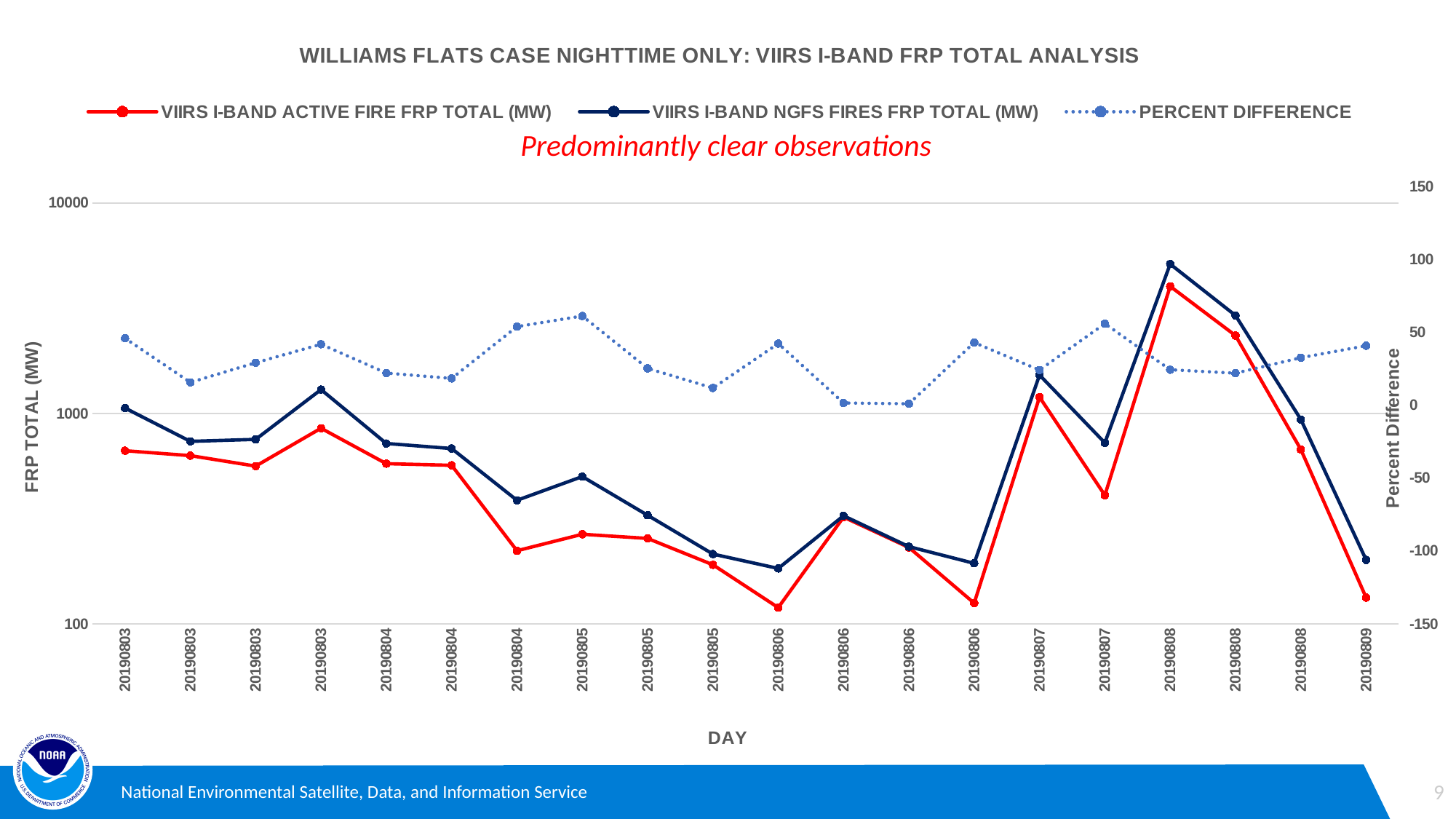
What is the title of the chart? WILLIAMS FLATS CASE NIGHTTIME ONLY: VIIRS I-BAND FRP TOTAL ANALYSIS How many data points are plotted along the x axis for each series? 20 At the first 20190803 point, which series is higher: VIIRS I-BAND ACTIVE FIRE FRP TOTAL (MW) or VIIRS I-BAND NGFS FIRES FRP TOTAL (MW)? VIIRS I-BAND NGFS FIRES FRP TOTAL (MW) On which day does the VIIRS I-BAND ACTIVE FIRE FRP TOTAL (MW) series reach its highest value? 20190808 How many series does the legend list? 3 Which series is drawn with a dotted line? PERCENT DIFFERENCE What kind of chart is shown on the slide? line chart Do the two FRP TOTAL series rise or fall between 20190808 and 20190809? fall On which day does the VIIRS I-BAND NGFS FIRES FRP TOTAL (MW) series reach its highest value? 20190808 Is the highest value of the VIIRS I-BAND NGFS FIRES FRP TOTAL (MW) series greater or less than 1000? greater Is the highest value of the PERCENT DIFFERENCE series greater or less than 50? greater Is the lowest value of the VIIRS I-BAND ACTIVE FIRE FRP TOTAL (MW) series greater or less than 1000? less